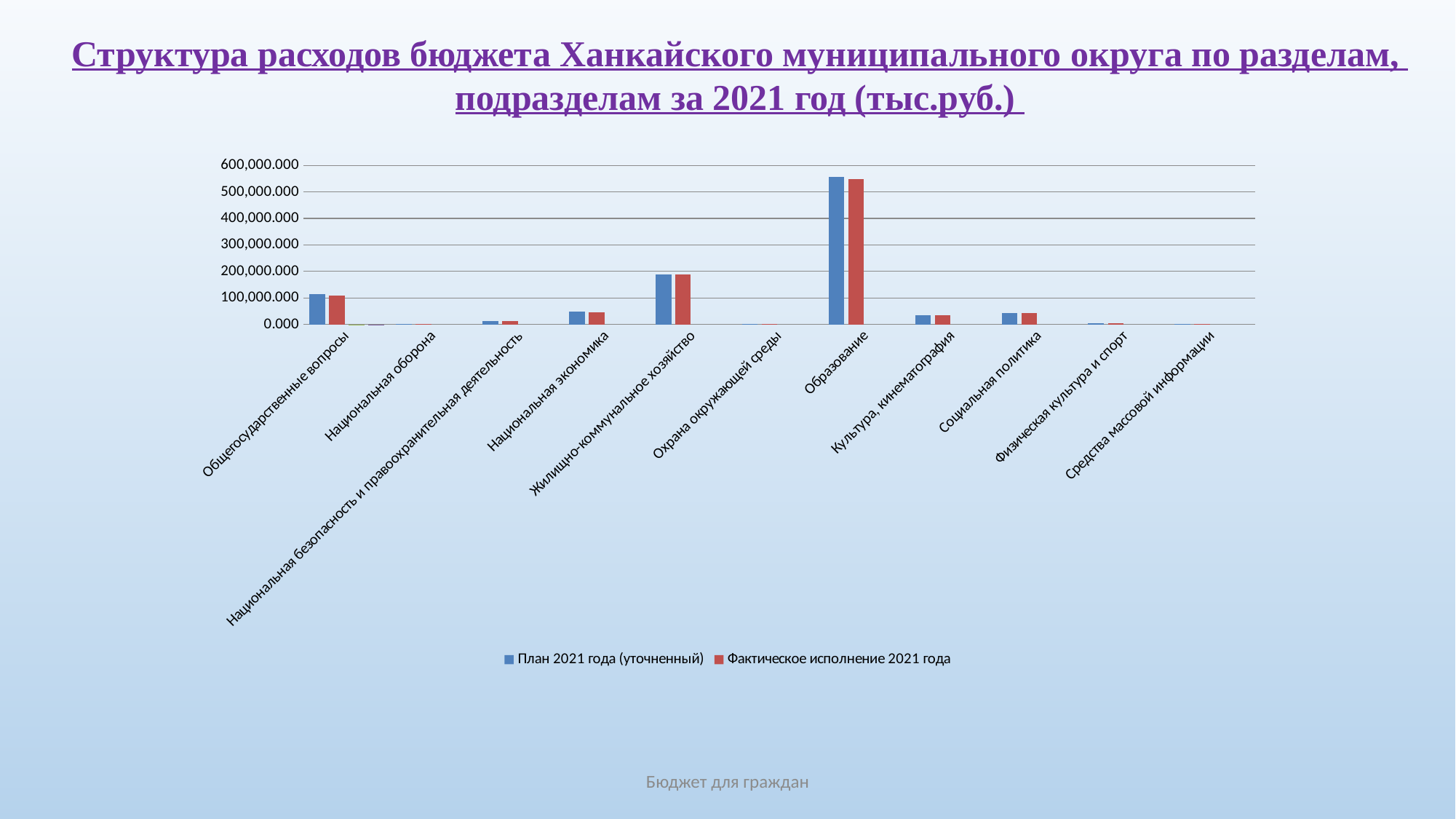
What is the highest value shown on the vertical axis of the chart? 600,000.000 Is the value of План 2021 года (уточненный) for Национальная экономика greater or less than 100,000.000? less What are the two series named in the chart legend? План 2021 года (уточненный) and Фактическое исполнение 2021 года Which has the larger value for План 2021 года (уточненный): Образование or Жилищно-коммунальное хозяйство? Образование What kind of chart is shown on the slide? Bar chart Which category has the highest value in the chart? Образование Is the value of План 2021 года (уточненный) for Образование greater or less than 500,000.000? greater Which has the larger value for Фактическое исполнение 2021 года: Жилищно-коммунальное хозяйство or Общегосударственные вопросы? Жилищно-коммунальное хозяйство How many categories are shown on the x axis of the chart? 11 Is the value of План 2021 года (уточненный) for Жилищно-коммунальное хозяйство greater or less than 100,000.000? greater How many series does the chart legend list? 2